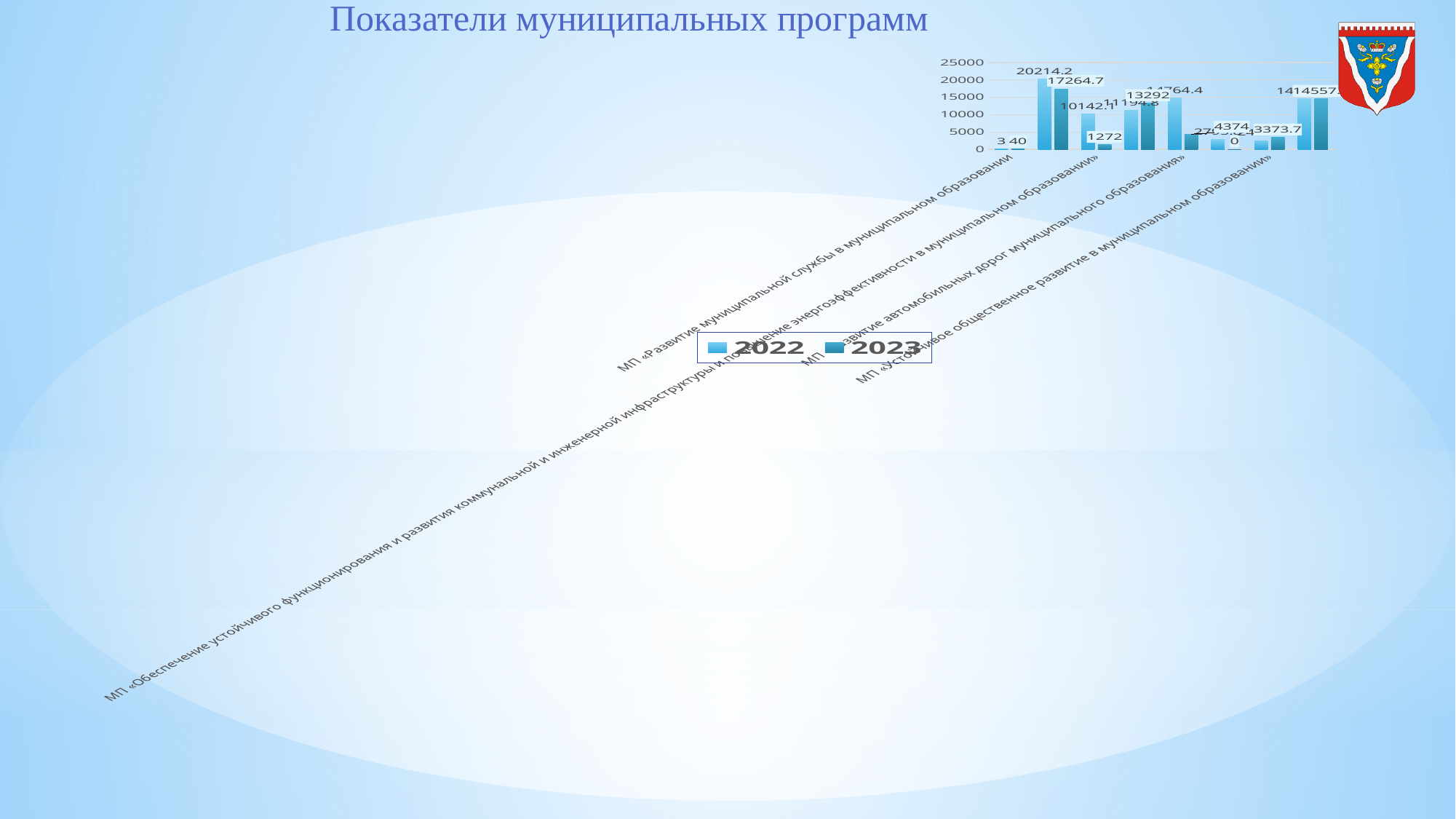
Which series are listed in the chart legend? 2022 and 2023 How many series does the chart legend list? 2 What is the highest data label value shown on the chart? 20214.2 What is the title of the slide containing the chart? Показатели муниципальных программ Is the highest bar on the chart greater or less than 20000? greater What kind of chart is shown on the slide? bar chart What is the maximum value shown on the vertical axis of the chart? 25000 What is the minimum value shown on the vertical axis of the chart? 0